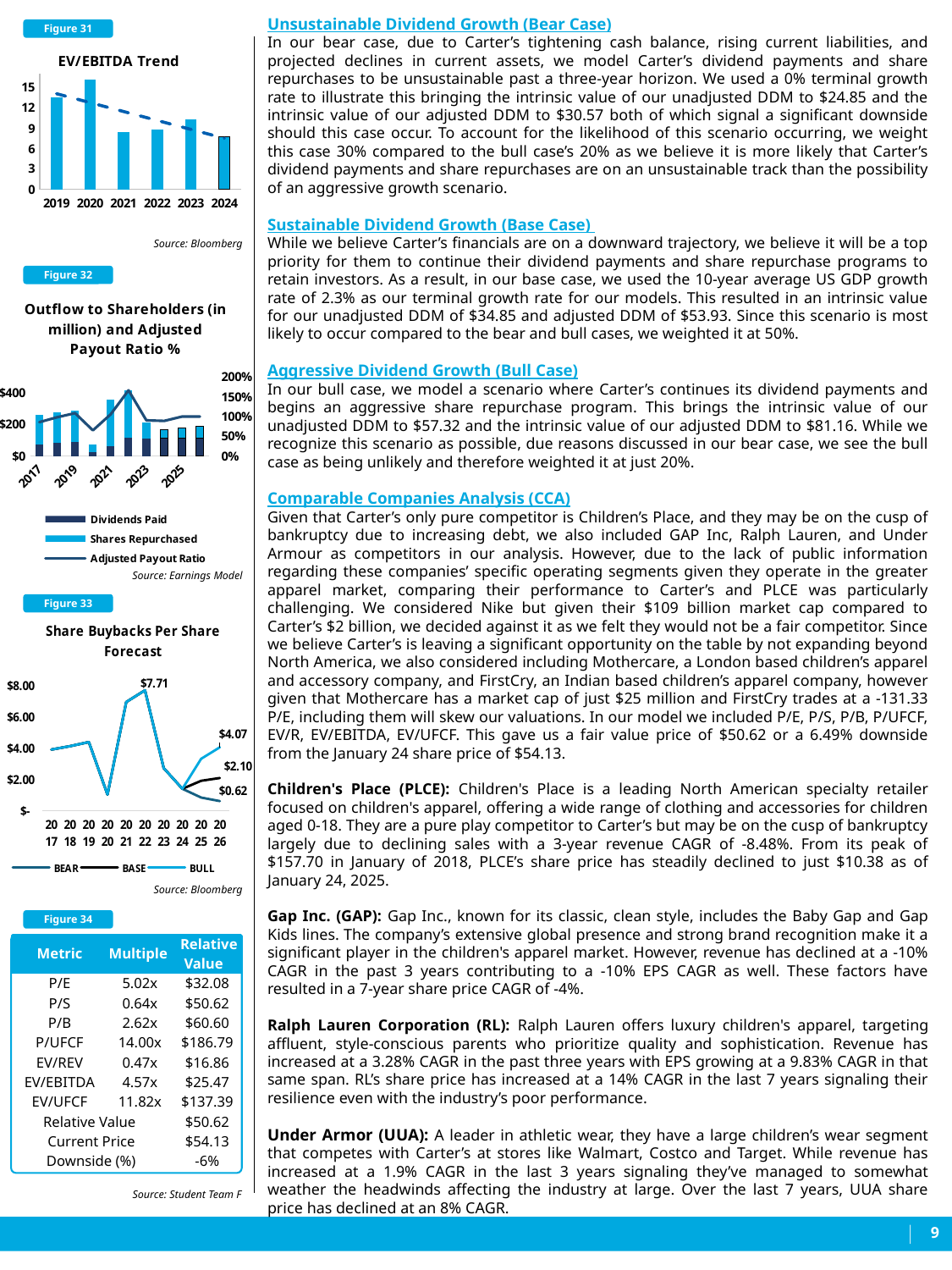
In the EV/EBITDA Trend chart (Figure 31), does the dashed trend line rise or fall from 2019 to 2024? fall In the EV/EBITDA Trend chart (Figure 31), which is larger, the value for 2020 or the value for 2021? 2020 In the EV/EBITDA Trend chart (Figure 31), is the value for 2019 greater or less than 12? greater In the EV/EBITDA Trend chart (Figure 31), is the value for 2024 greater or less than 9? less In the Share Buybacks Per Share Forecast chart (Figure 33), what is the peak value labelled on the chart? $7.71 In the Share Buybacks Per Share Forecast chart (Figure 33), what is the BULL value labelled for 2026? $4.07 How many series does the legend list in the Outflow to Shareholders chart (Figure 32)? 3 In the EV/EBITDA Trend chart (Figure 31), how many years are shown on the x axis? 6 In the Outflow to Shareholders chart (Figure 32), which series is plotted as a line rather than bars? Adjusted Payout Ratio In the EV/EBITDA Trend chart (Figure 31), which year has the highest EV/EBITDA value? 2020 In the Share Buybacks Per Share Forecast chart (Figure 33), what is the difference between the BULL value ($4.07) and the BEAR value ($0.62) at the end of the forecast? $3.45 What kind of chart is the EV/EBITDA Trend chart (Figure 31)? bar chart